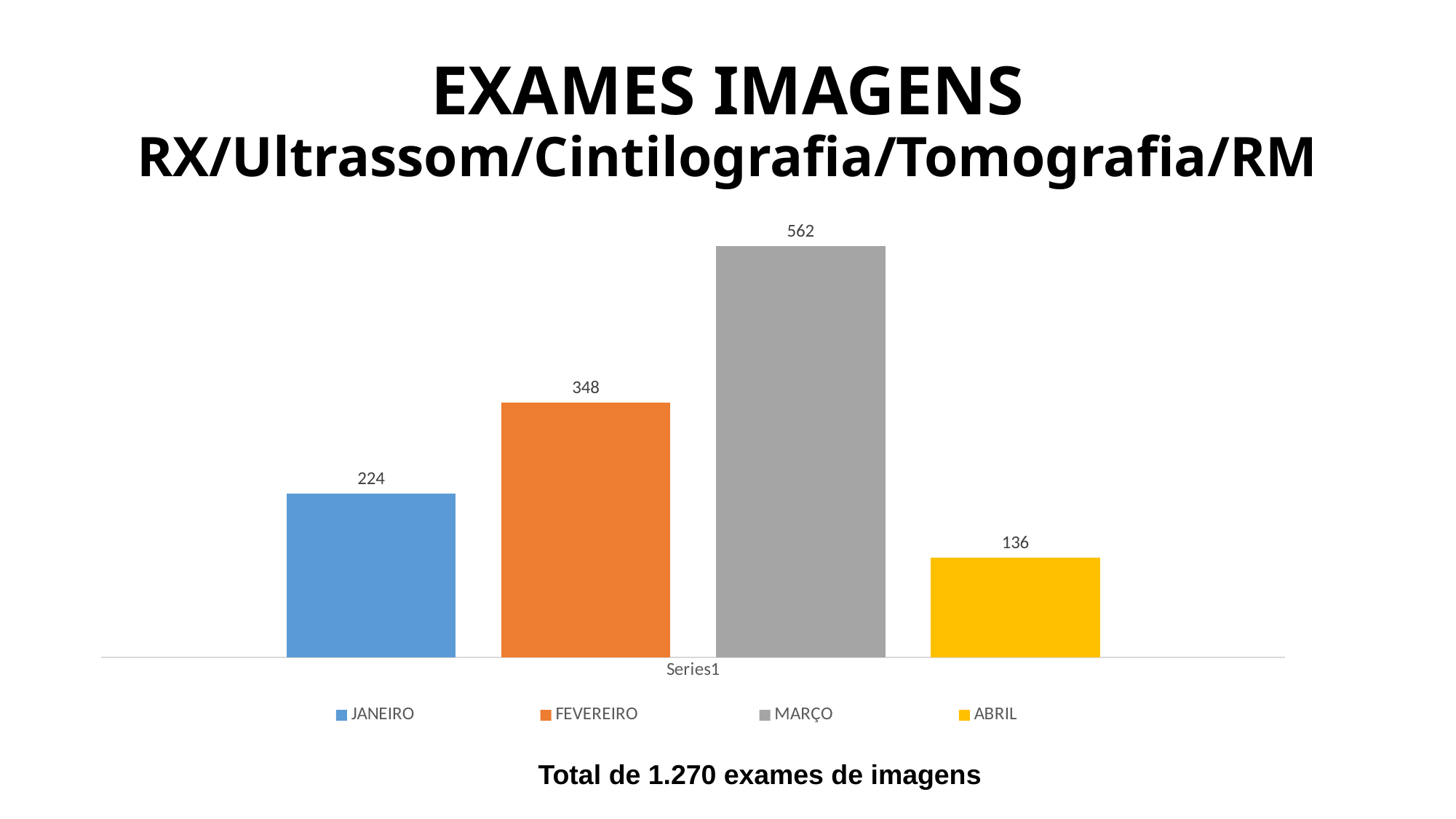
What is the value for MARÇO? 562 What is the value for ABRIL? 136 What kind of chart is shown on the slide? Bar chart What is the value for FEVEREIRO? 348 Which is larger, the value for JANEIRO or the value for FEVEREIRO? FEVEREIRO Which month has the lowest value? ABRIL What is the value for JANEIRO? 224 Which month has the highest value? MARÇO What is the difference between the values for JANEIRO and ABRIL? 88 How many entries does the legend list? 4 How many bars are shown in the chart? 4 What is the difference between the values for MARÇO and FEVEREIRO? 214